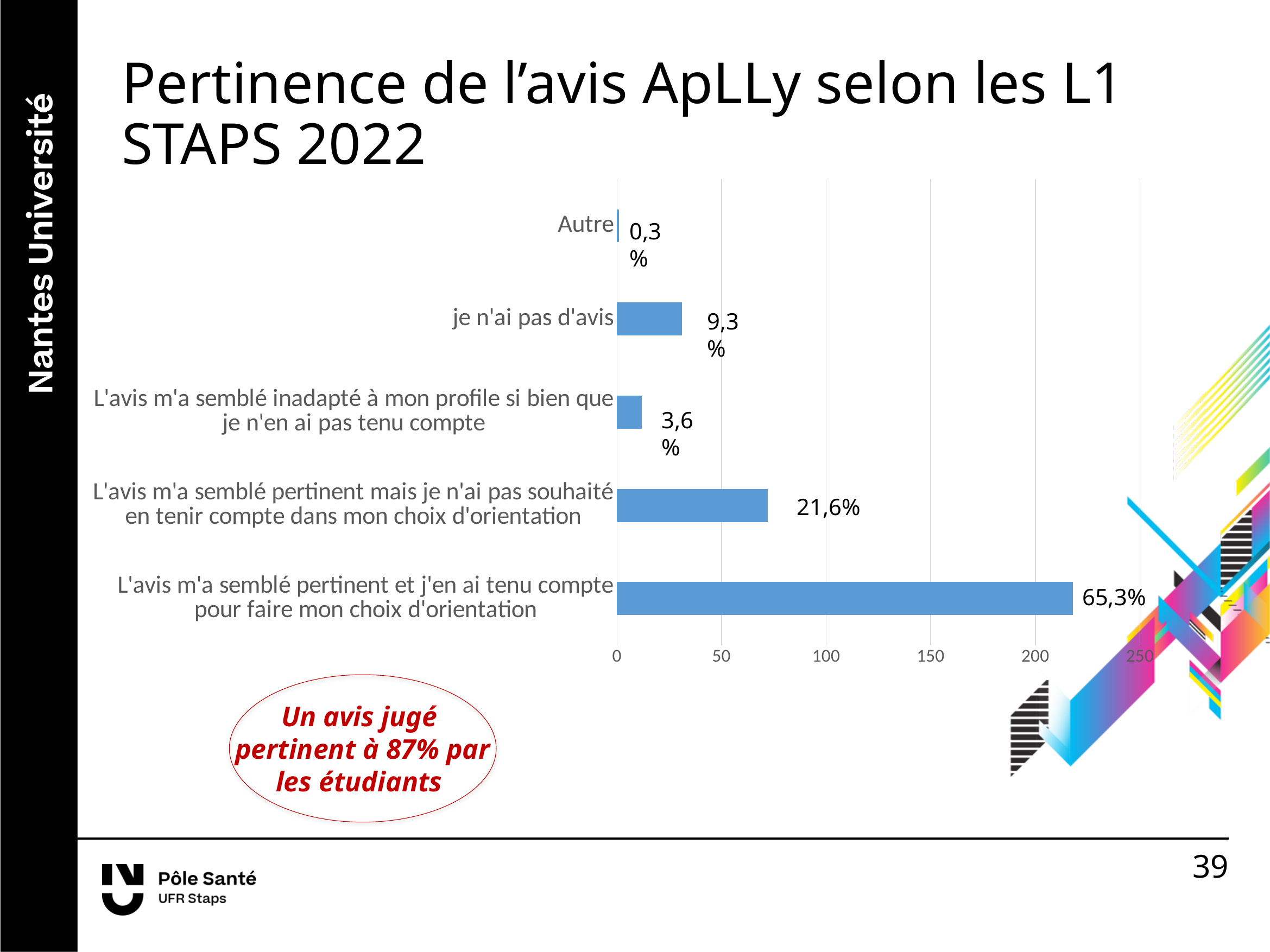
What is the value shown for "je n'ai pas d'avis"? 9,3% Is the bar for "L'avis m'a semblé pertinent et j'en ai tenu compte pour faire mon choix d'orientation" greater or less than 200 on the axis? greater What is the title of the slide containing the chart? Pertinence de l'avis ApLLy selon les L1 STAPS 2022 What kind of chart is shown on the slide? bar chart Which is larger: the value for "je n'ai pas d'avis" or the value for "L'avis m'a semblé inadapté à mon profile si bien que je n'en ai pas tenu compte"? je n'ai pas d'avis Which category has the highest value? L'avis m'a semblé pertinent et j'en ai tenu compte pour faire mon choix d'orientation What is the value shown for "L'avis m'a semblé pertinent mais je n'ai pas souhaité en tenir compte dans mon choix d'orientation"? 21,6% What is the value shown for "L'avis m'a semblé pertinent et j'en ai tenu compte pour faire mon choix d'orientation"? 65,3% How many categories does the chart show? 5 What is the value shown for "Autre"? 0,3% Which category has the lowest value? Autre What is the difference between the values for "L'avis m'a semblé pertinent et j'en ai tenu compte pour faire mon choix d'orientation" and "L'avis m'a semblé pertinent mais je n'ai pas souhaité en tenir compte dans mon choix d'orientation"? 43,7%